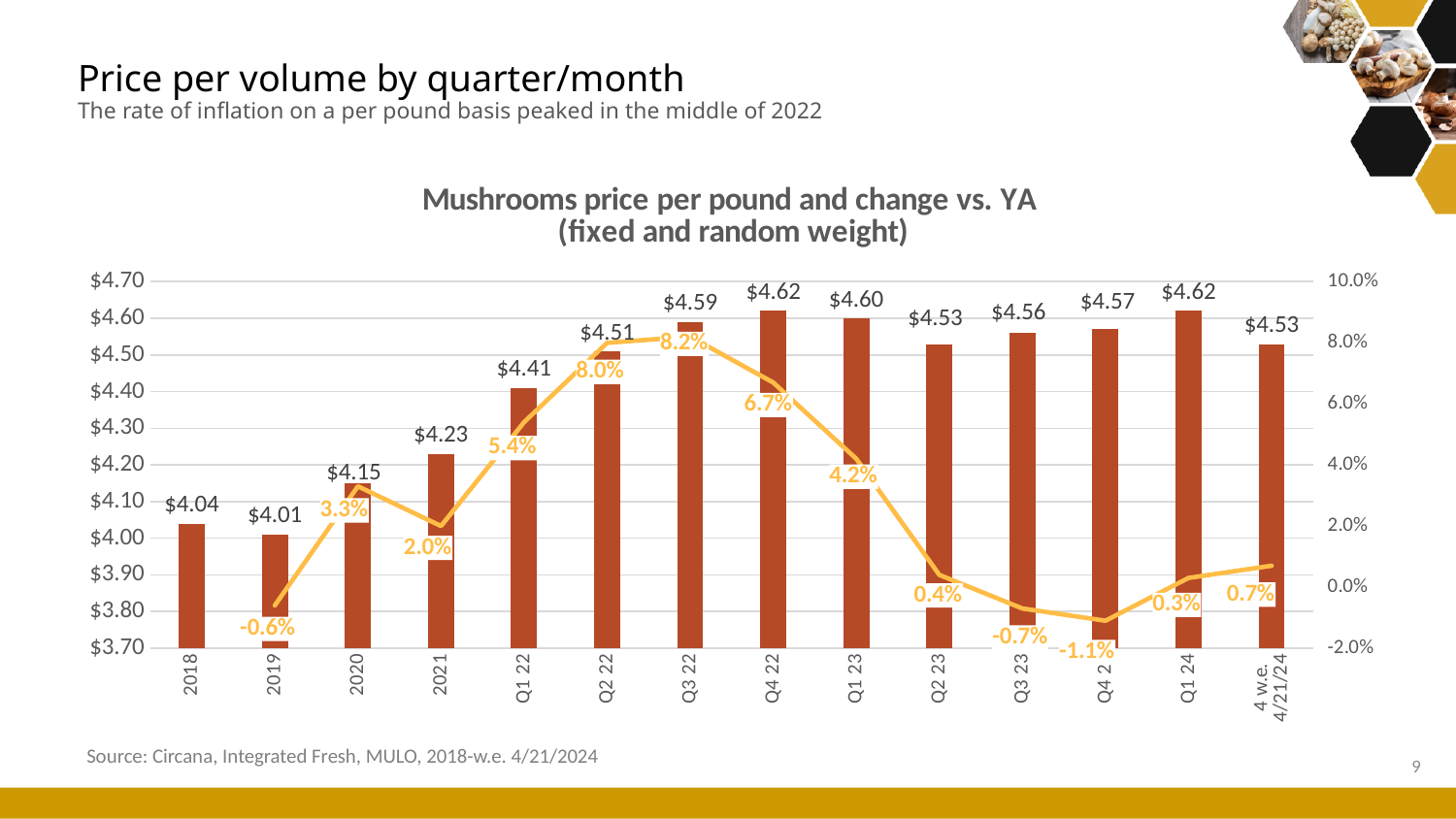
How many periods are shown on the x axis? 14 What is the price per pound for the 4 w.e. 4/21/24 period? $4.53 What is the title of the chart? Mushrooms price per pound and change vs. YA (fixed and random weight) What kind of chart is this? Combined bar and line chart Which is higher, the price per pound in Q1 23 or in Q2 23? Q1 23 Does the price per pound rise or fall from 2019 to Q4 22? Rise Which period has the highest change vs. YA? Q3 22 What is the mushrooms price per pound for Q3 22? $4.59 What is the difference in price per pound between Q4 22 and 2018? $0.58 What is the change vs. YA shown for Q2 22? 8.0% What is the change vs. YA shown for Q3 23? -0.7% Which period has the lowest price per pound? 2019